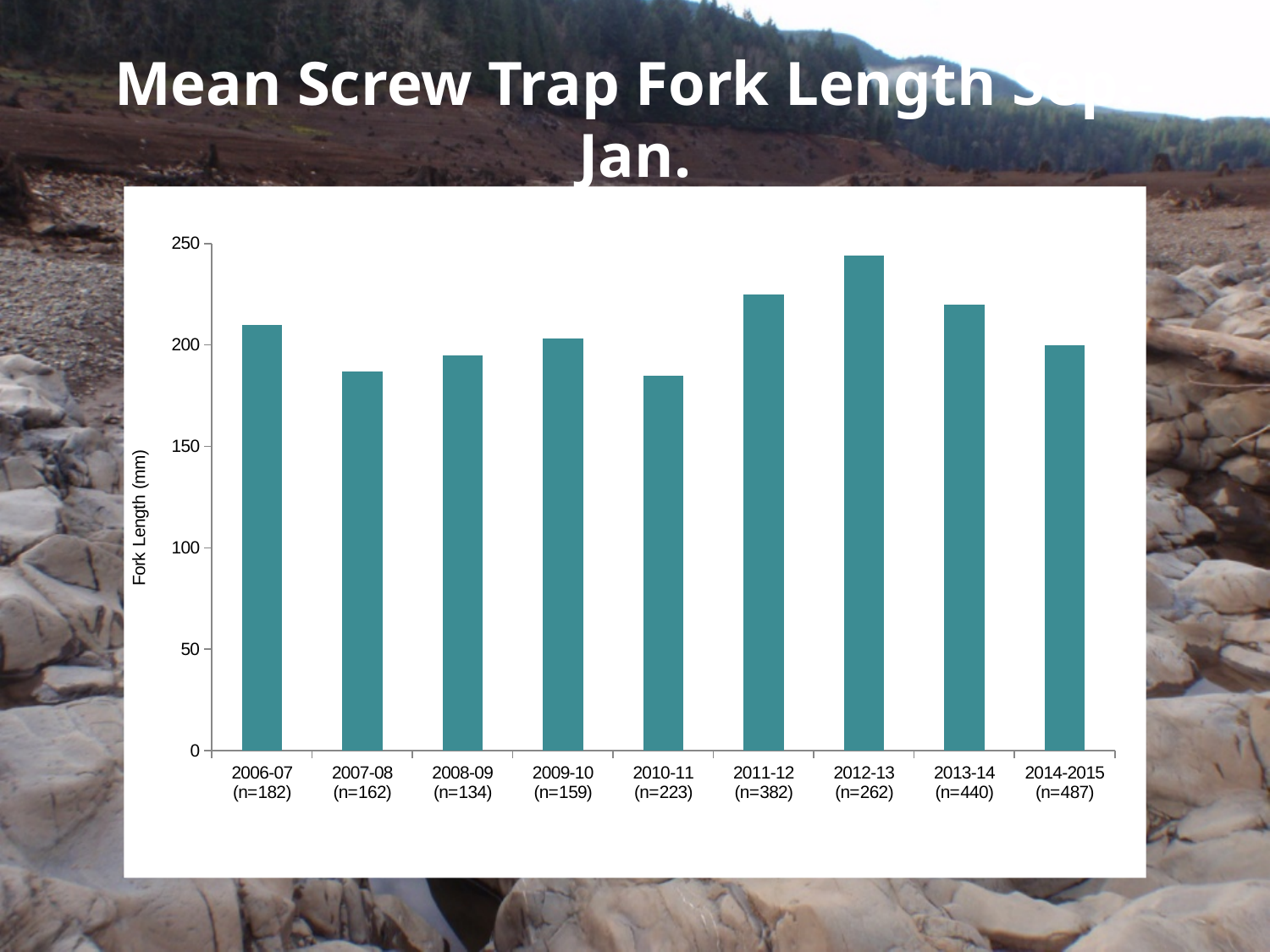
Which is larger, the value for 2012-13 or the value for 2006-07? 2012-13 How many year categories are shown on the x axis of the chart? 9 Which year has the highest mean fork length? 2012-13 Is the value for 2010-11 greater or less than 200? less What is the label on the y axis of the chart? Fork Length (mm) Is the value for 2007-08 greater or less than 200? less What kind of chart is shown on the slide? bar chart Which is larger, the value for 2014-2015 or the value for 2010-11? 2014-2015 Is the value for 2006-07 greater or less than 200? greater What sample size (n) is shown for the 2014-2015 category? n=487